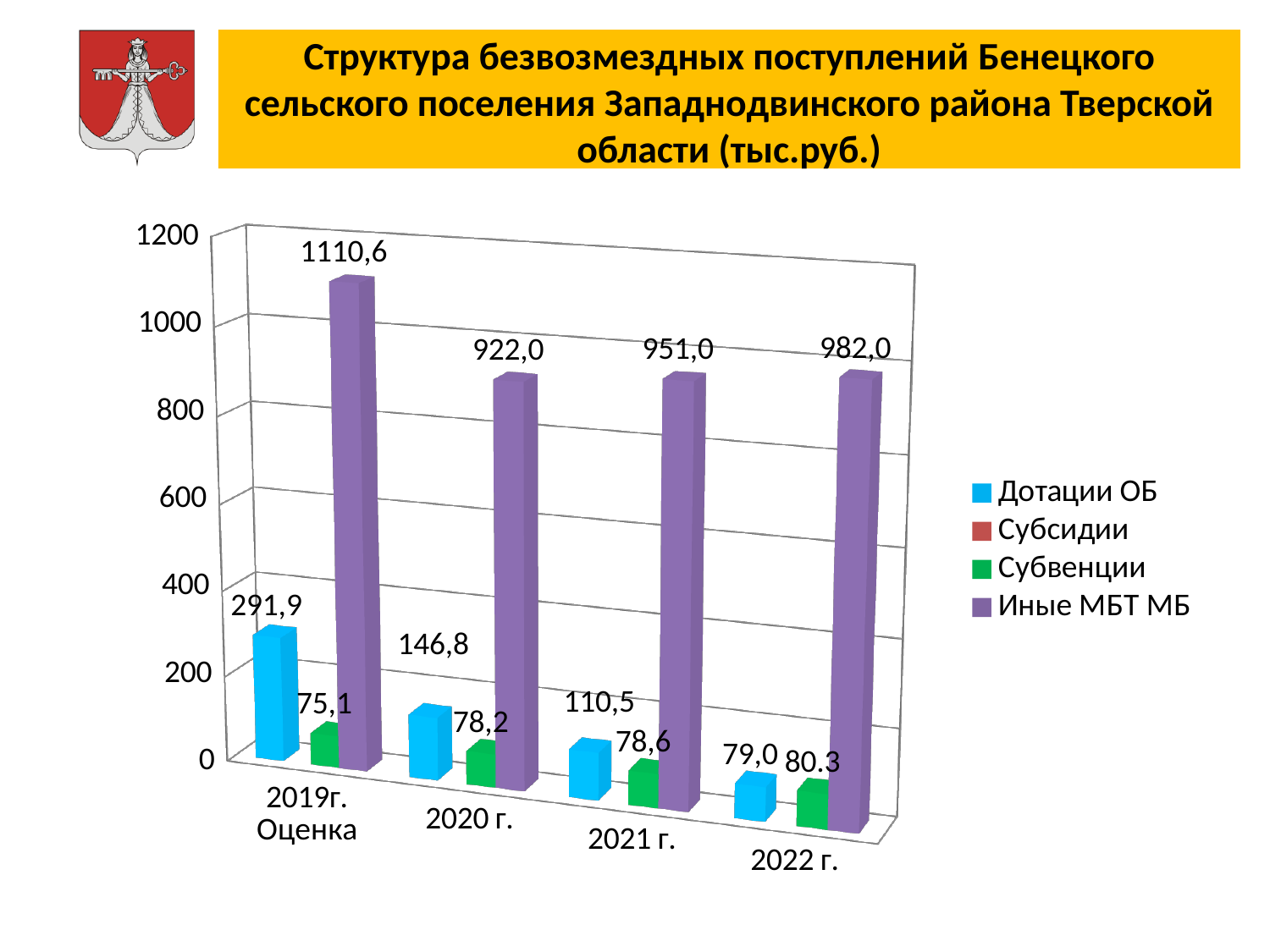
In which year is Иные МБТ МБ the highest? 2019г. Оценка What is the difference between Иные МБТ МБ in 2022 г. and in 2020 г.? 60,0 What is the value of Субвенции for 2020 г.? 78,2 What is the value of Иные МБТ МБ for 2019г. Оценка? 1110,6 What type of chart is shown on the slide? Bar chart What is the value of Дотации ОБ for 2021 г.? 110,5 Does Дотации ОБ rise or fall from 2019г. Оценка to 2022 г.? Fall In which year is Дотации ОБ the lowest? 2022 г. How many series does the legend list? 4 Which is larger: Дотации ОБ in 2020 г. or Субвенции in 2020 г.? Дотации ОБ in 2020 г. Which legend entry is shown in purple? Иные МБТ МБ How many categories (years) are shown on the x axis? 4